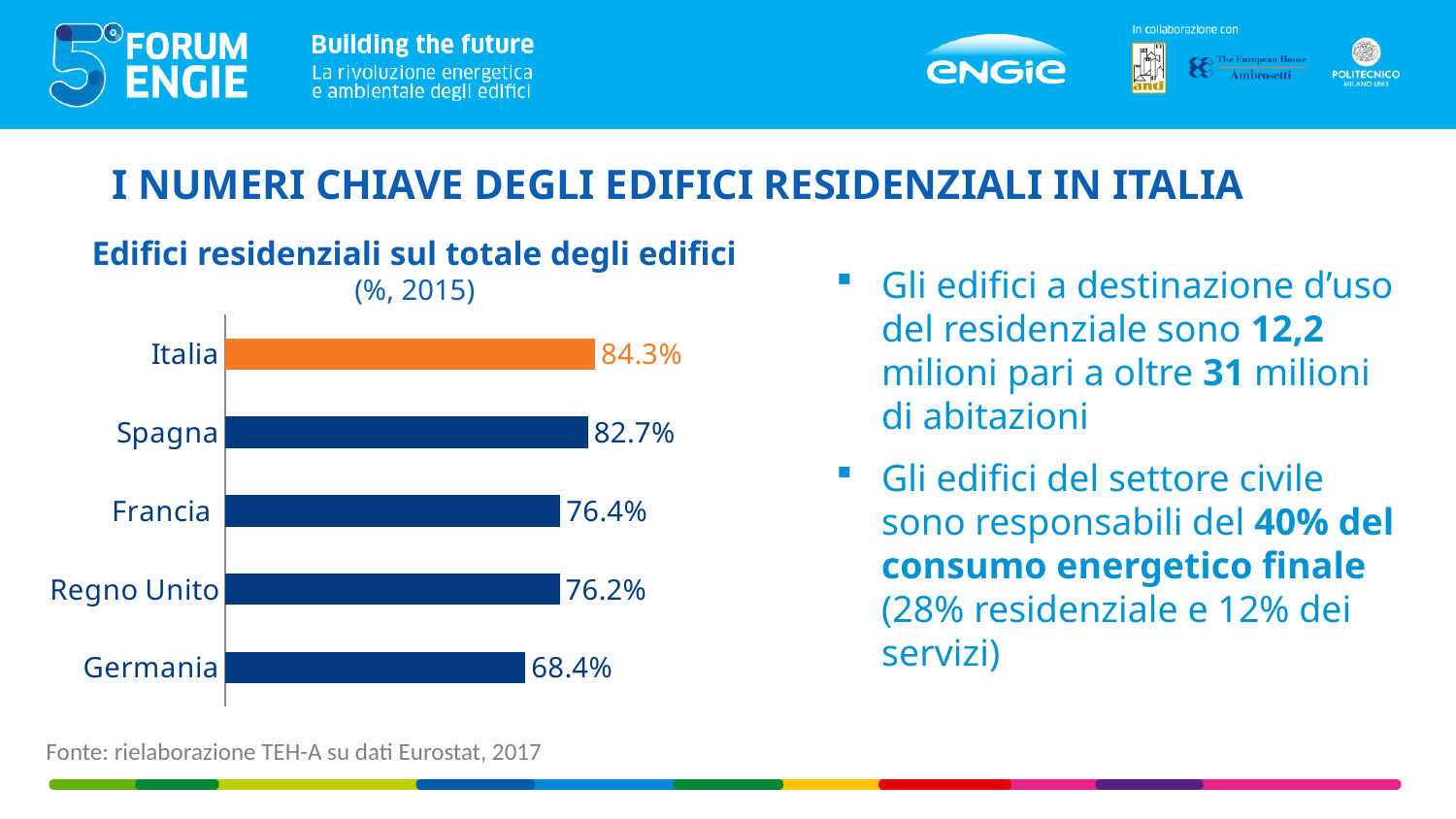
Which bar is coloured orange? Italia What is the value for Italia? 84.3% What is the value for Francia? 76.4% What is the value for Germania? 68.4% Which is larger, the value for Spagna or the value for Regno Unito? Spagna What is the difference between the values for Spagna and Francia? 6.3 percentage points How many countries are shown in the chart? 5 What is the difference between the values for Italia and Germania? 15.9 percentage points What kind of chart is shown on the slide? Bar chart What is the title of the chart? Edifici residenziali sul totale degli edifici (%, 2015) Which country has the lowest share of residential buildings? Germania Which country has the highest share of residential buildings? Italia